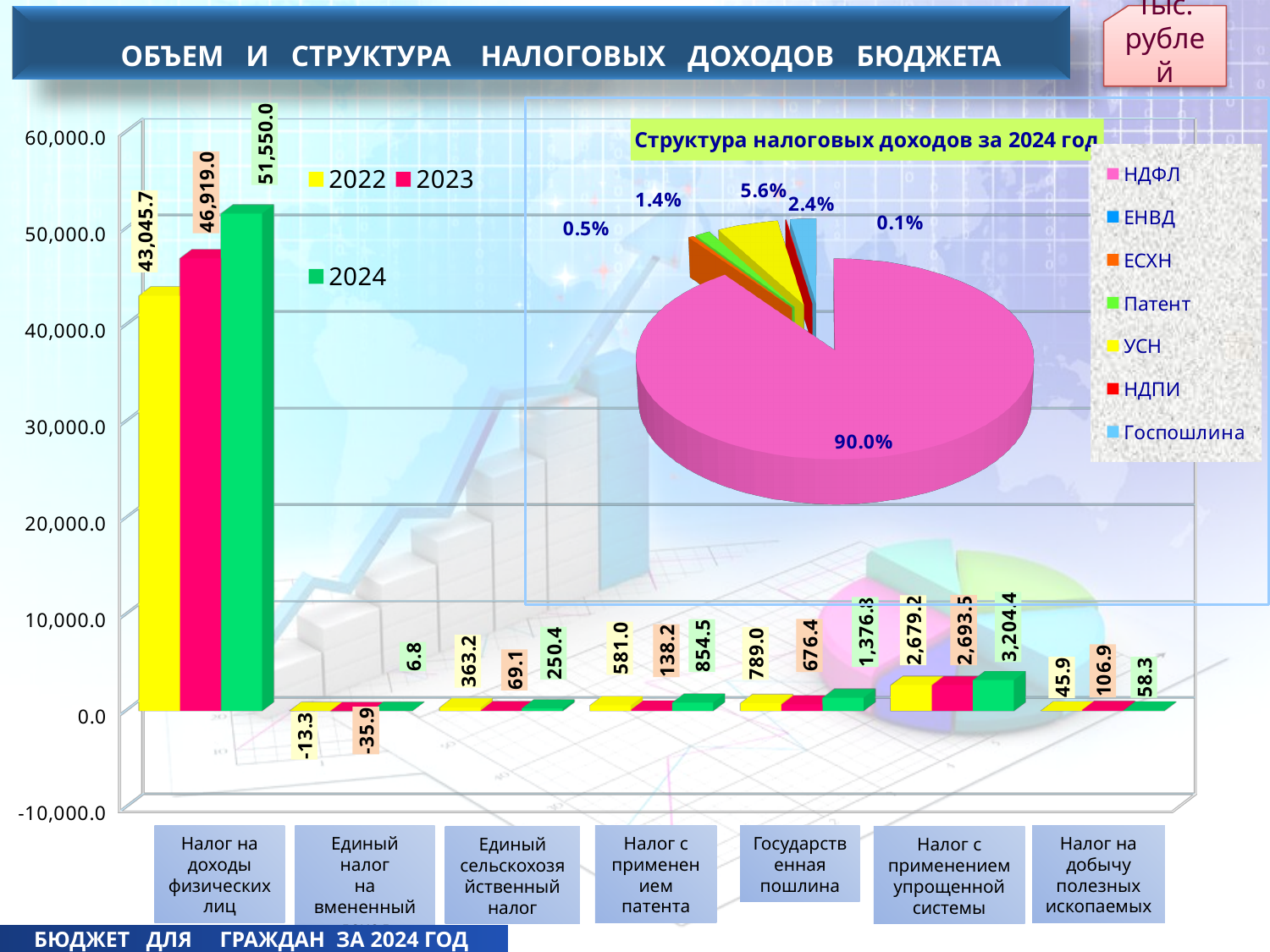
In the bar chart on the left, what is the 2023 value for Единый налог на вмененный? -35.9 In the bar chart on the left, how many tax categories are shown on the x axis? 7 In the bar chart on the left, how many series does the legend list? 3 In the pie chart 'Структура налоговых доходов за 2024 год', what share does НДФЛ have? 90.0% What kind of chart is the large chart on the left of the slide? bar chart In the bar chart on the left, do the values for Налог на доходы физических лиц rise or fall from 2022 to 2024? rise In the pie chart 'Структура налоговых доходов за 2024 год', how many entries does the legend list? 7 In the bar chart on the left, by how much did Налог на доходы физических лиц increase from 2022 to 2024? 8,504.3 In the bar chart on the left, what is the 2023 value for Государственная пошлина? 676.4 In the bar chart on the left, what is the 2024 value for Налог на доходы физических лиц? 51,550.0 In the bar chart on the left, which year has the larger value for Налог с применением упрощенной системы, 2022 or 2023? 2023 In the pie chart 'Структура налоговых доходов за 2024 год', what share is labelled for УСН? 5.6%